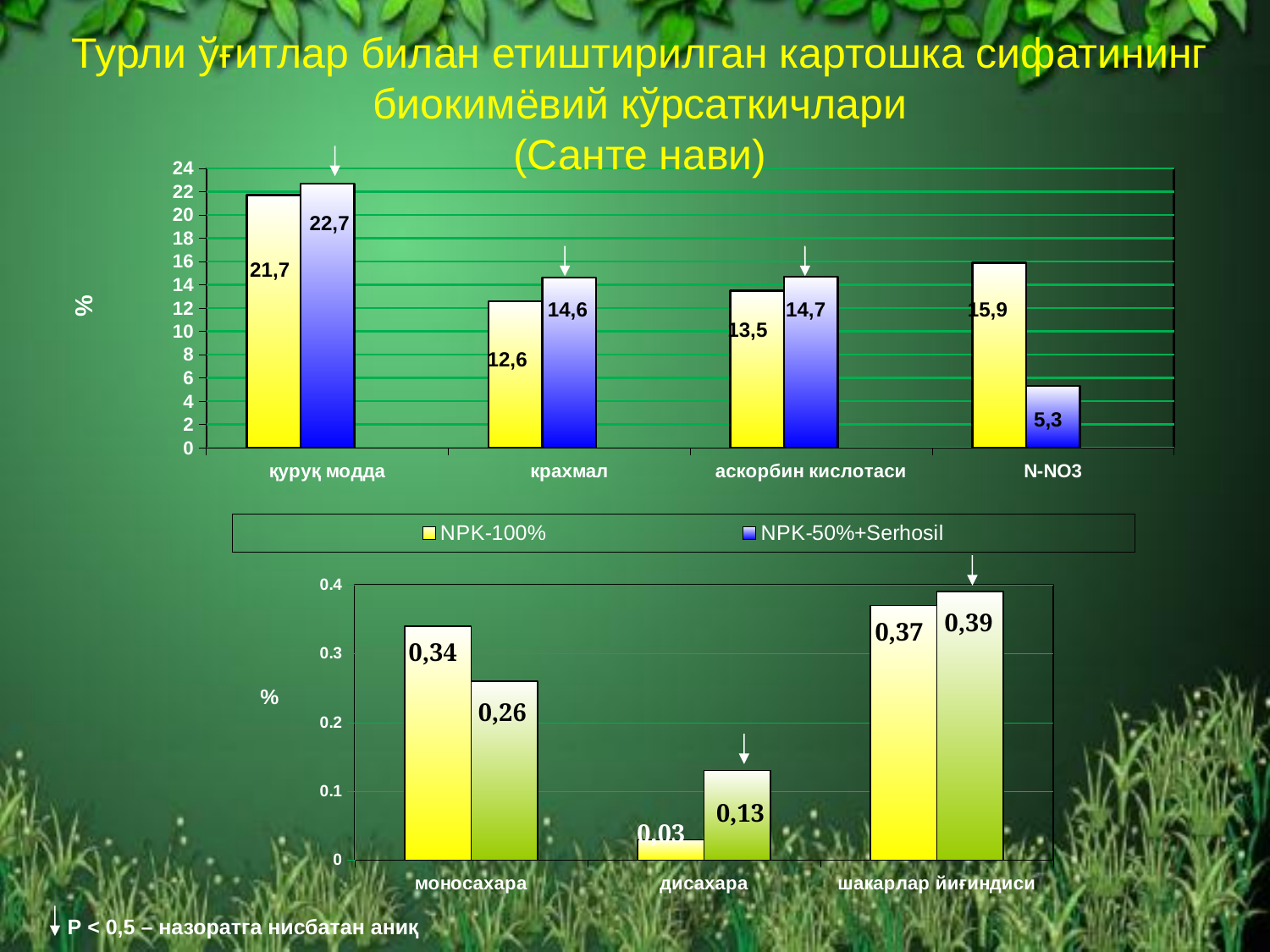
In the bottom chart, what is the value of the yellow bar for дисахара? 0,03 In the top chart, which category has the lowest NPK-50%+Serhosil value? N-NO3 What kind of chart is the bottom chart? bar chart In the bottom chart, what is the value of the green bar for шакарлар йиғиндиси? 0,39 In the top chart, what is the difference between the NPK-100% and NPK-50%+Serhosil values for N-NO3? 10,6 In the top chart, what is the NPK-50%+Serhosil value for N-NO3? 5,3 How many categories are shown on the x axis of the top chart? 4 In the top chart, what is the NPK-50%+Serhosil value for крахмал? 14,6 In the top chart, for аскорбин кислотаси, which is larger: NPK-100% or NPK-50%+Serhosil? NPK-50%+Serhosil How many series does the legend list? 2 In the top chart, what is the NPK-100% value for қуруқ модда? 21,7 In the top chart, which category has the highest NPK-100% value? қуруқ модда